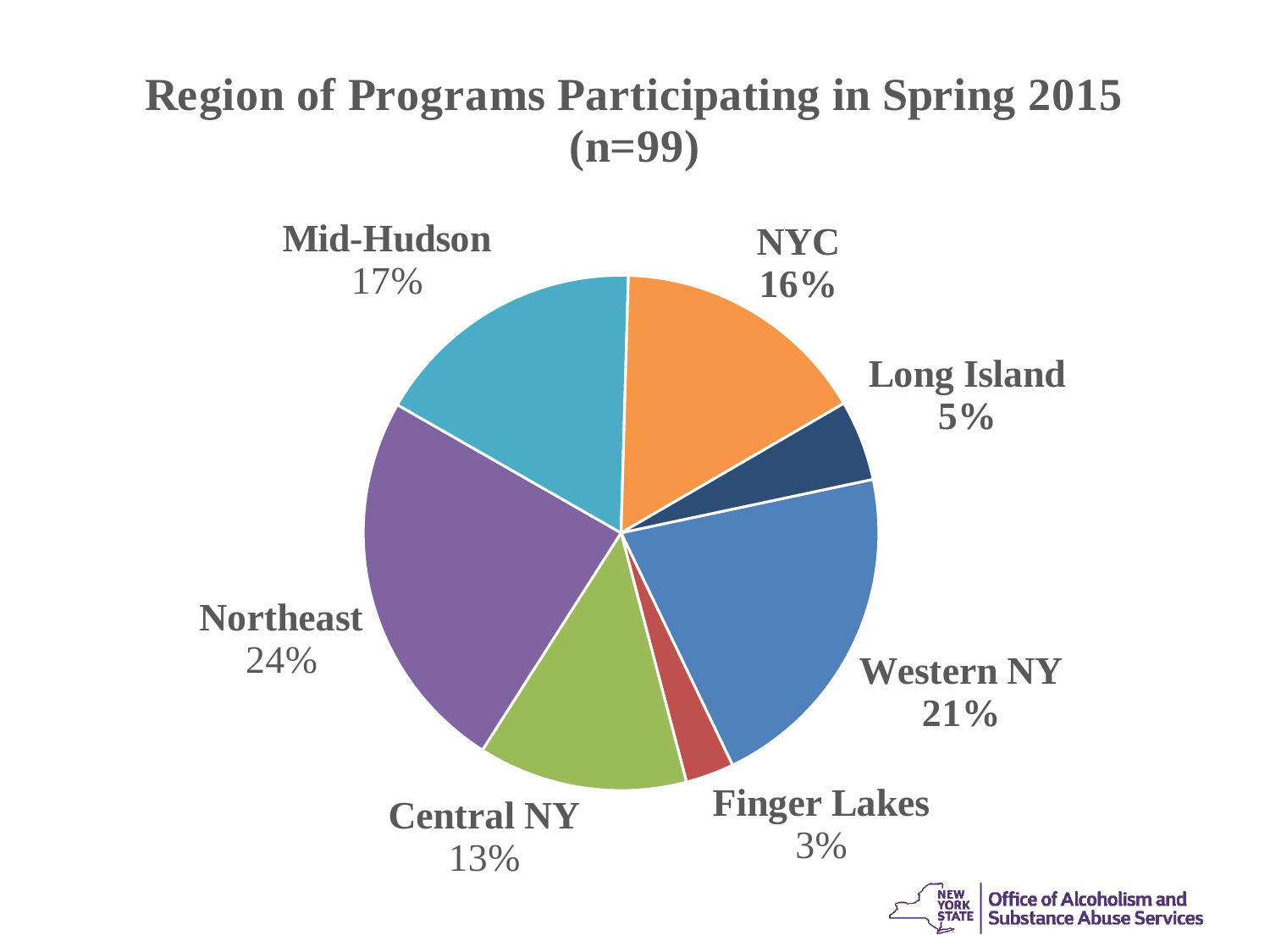
What percentage of participating programs were from Western NY? 21% What is the title of the chart? Region of Programs Participating in Spring 2015 (n=99) How many regions are shown in the pie chart? 7 Which region has a larger share, NYC or Mid-Hudson? Mid-Hudson Which region has the largest share of participating programs? Northeast What kind of chart is shown on the slide? Pie chart What is the difference in percentage points between the Northeast and Central NY shares? 11 Which region has the smallest share of participating programs? Finger Lakes What is the combined share of NYC and Long Island? 21% What share of programs participating in Spring 2015 were from the Northeast region? 24% What share of the pie does Long Island represent? 5% Which region has a larger share, Western NY or Central NY? Western NY